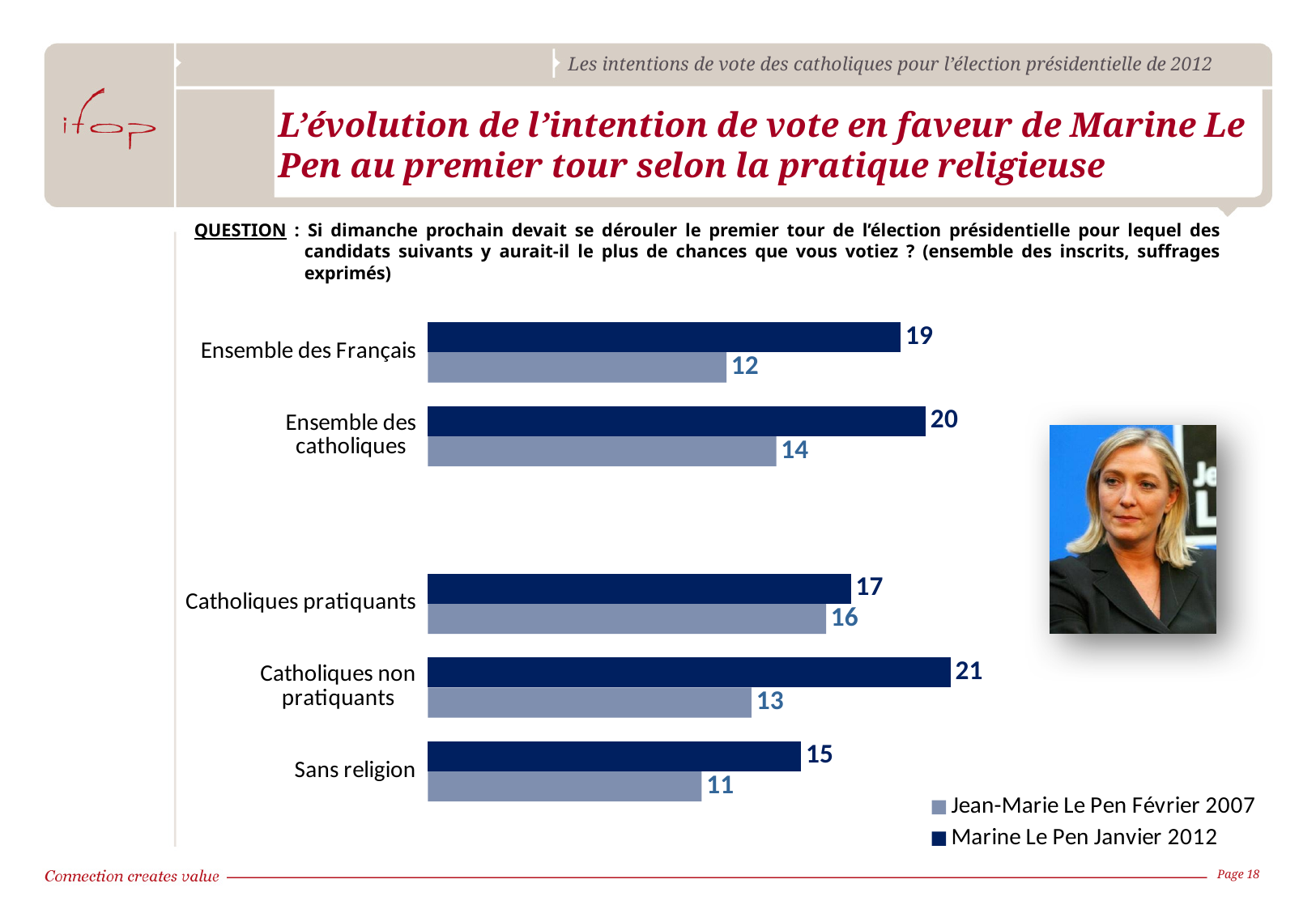
What is the difference between the Marine Le Pen Janvier 2012 and Jean-Marie Le Pen Février 2007 values for Catholiques non pratiquants? 8 What is the difference between the Marine Le Pen Janvier 2012 values for Ensemble des catholiques and Sans religion? 5 Which is larger for Ensemble des Français: the Marine Le Pen Janvier 2012 value or the Jean-Marie Le Pen Février 2007 value? Marine Le Pen Janvier 2012 What is the value for Jean-Marie Le Pen Février 2007 among Sans religion? 11 What is the value for Jean-Marie Le Pen Février 2007 among Catholiques pratiquants? 16 How many categories are shown on the chart? 5 Which series is shown in dark blue? Marine Le Pen Janvier 2012 How many series does the legend list? 2 Which category has the highest value for Marine Le Pen Janvier 2012? Catholiques non pratiquants What is the value for Marine Le Pen Janvier 2012 among Ensemble des catholiques? 20 What kind of chart is shown on the slide? Bar chart Which category has the lowest value for Jean-Marie Le Pen Février 2007? Sans religion